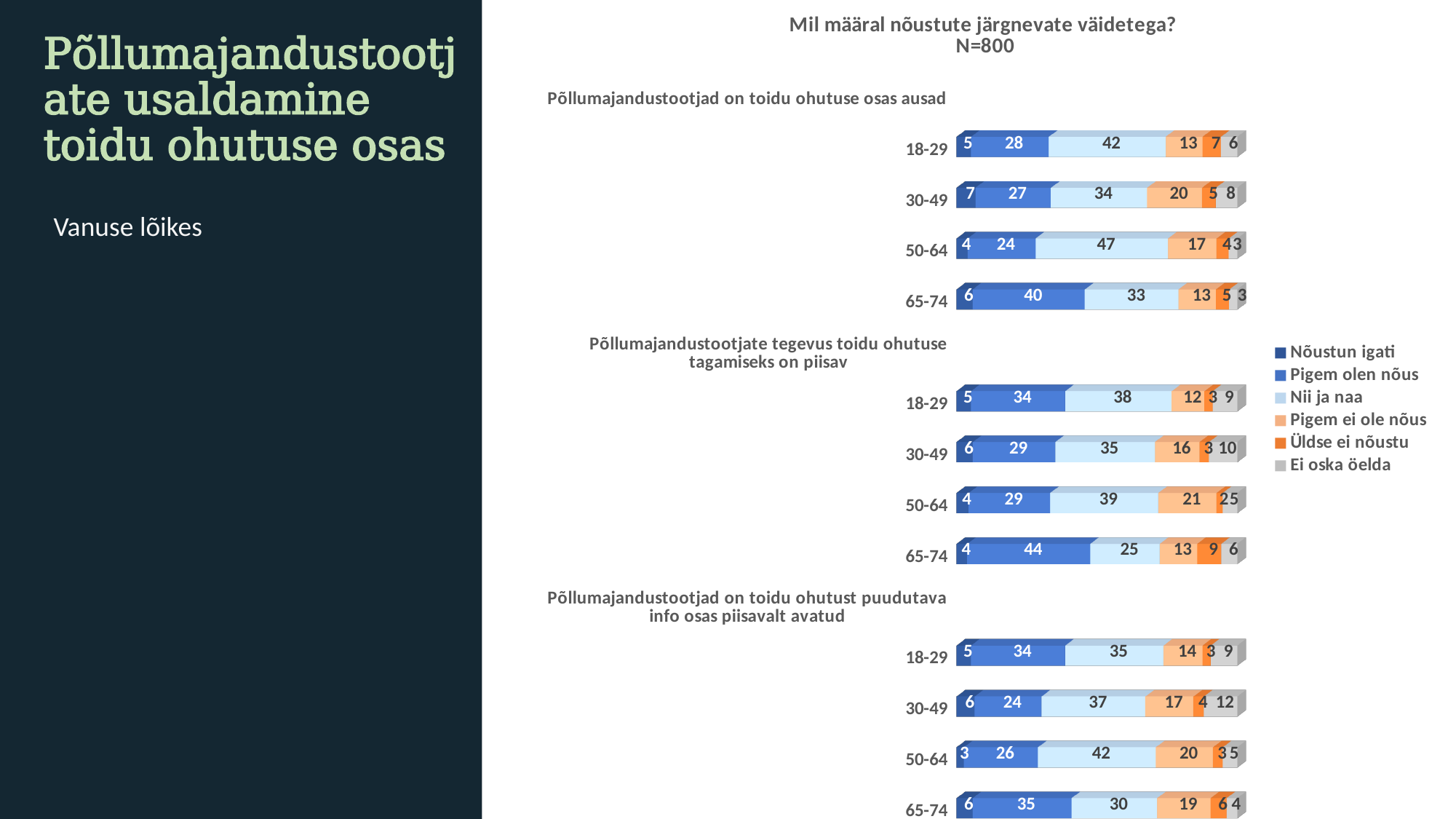
For the statement 'Põllumajandustootjad on toidu ohutuse osas ausad', what is the difference between the 'Nii ja naa' values for the 50-64 and 30-49 age groups? 13 For the statement 'Põllumajandustootjad on toidu ohutuse osas ausad', which age group has the highest 'Pigem olen nõus' value? 65-74 How many age groups are shown for each statement? 4 For the statement 'Põllumajandustootjad on toidu ohutuse osas ausad', what is the 'Nii ja naa' value for the 50-64 age group? 47 For the statement 'Põllumajandustootjad on toidu ohutust puudutava info osas piisavalt avatud', which is larger: the 'Pigem ei ole nõus' value for 50-64 or for 18-29? 50-64 What kind of chart is shown on the slide? stacked bar chart For the statement 'Põllumajandustootjad on toidu ohutust puudutava info osas piisavalt avatud', what is the 'Ei oska öelda' value for the 30-49 age group? 12 How many series does the legend list? 6 What is the sample size (N) stated in the chart title? N=800 For the statement 'Põllumajandustootjate tegevus toidu ohutuse tagamiseks on piisav', what is the 'Pigem olen nõus' value for the 65-74 age group? 44 For the statement 'Põllumajandustootjate tegevus toidu ohutuse tagamiseks on piisav', which age group has the lowest 'Nii ja naa' value? 65-74 For the statement 'Põllumajandustootjate tegevus toidu ohutuse tagamiseks on piisav', what is the 'Üldse ei nõustu' value for the 65-74 age group? 9